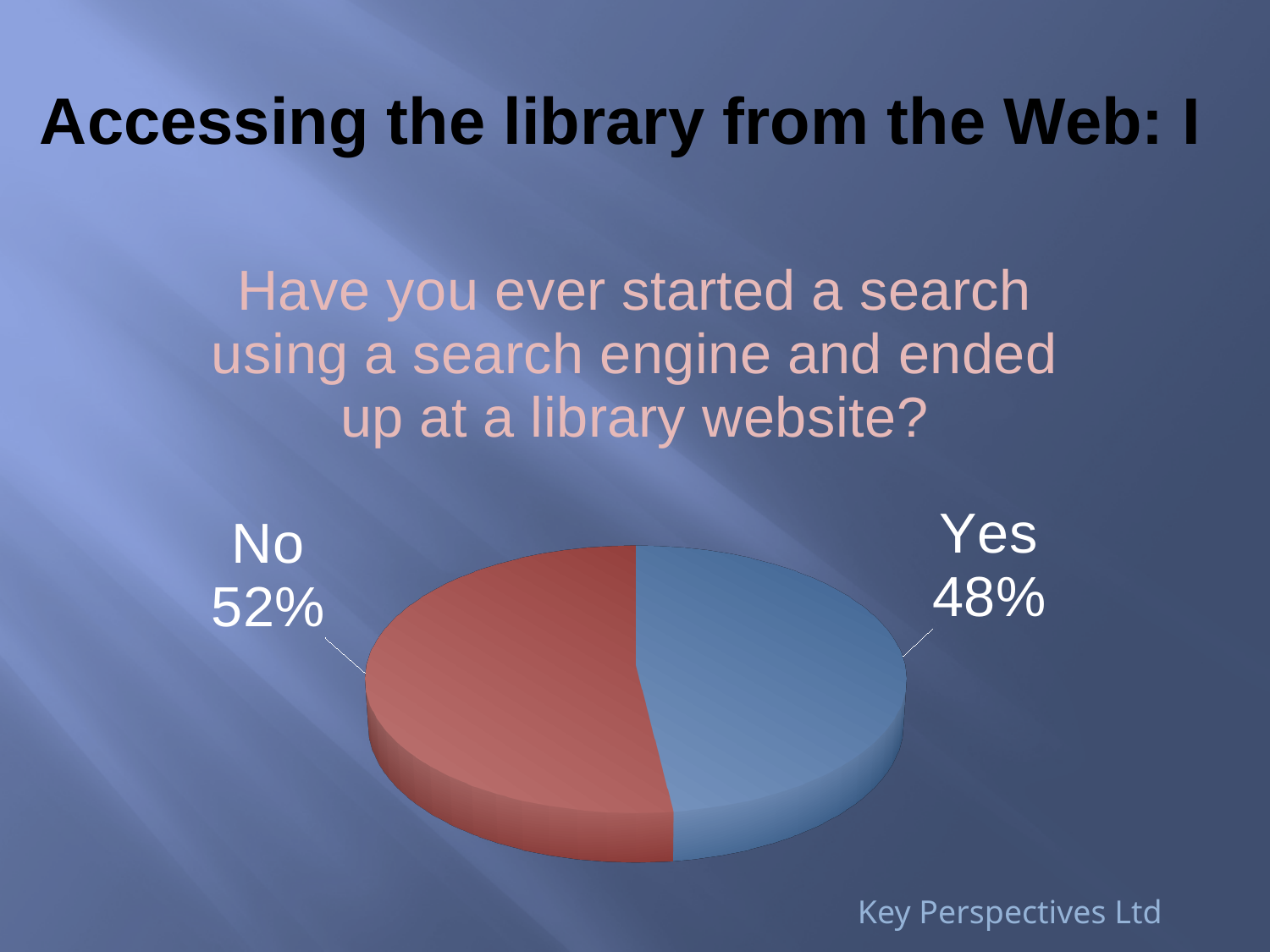
What colour is the "Yes" slice? blue What kind of chart is shown on the slide? pie chart What percentage of respondents answered "No"? 52% What share of the pie does the "No" slice represent? 52% What is the difference in percentage points between the "No" and "Yes" slices? 4 How many slices does the pie chart have? 2 Which response has the larger share of the pie? No Which response has the smaller share of the pie? Yes Is the share for "Yes" larger or smaller than the share for "No"? smaller What percentage of respondents answered "Yes"? 48% What question does the pie chart present responses to? Have you ever started a search using a search engine and ended up at a library website?